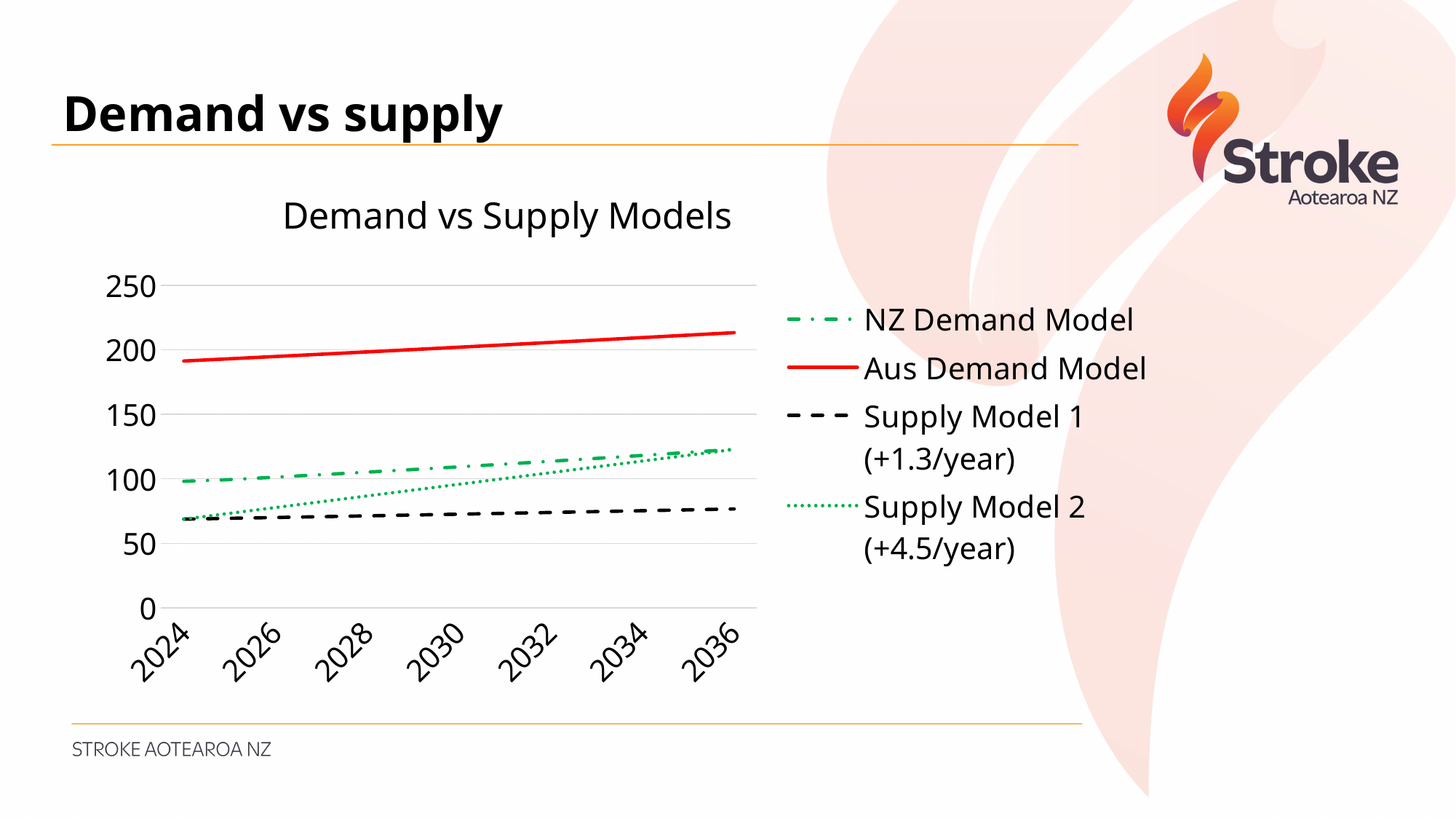
Is the value for the NZ Demand Model in 2036 greater or less than 100? greater How many year labels are shown on the x axis? 7 Which series has the lowest value in 2036? Supply Model 1 (+1.3/year) Which series has the highest values across the whole period? Aus Demand Model Is the value for the Aus Demand Model in 2024 greater or less than 150? greater In 2036, which is larger: Supply Model 1 or Supply Model 2? Supply Model 2 How many series does the chart legend list? 4 What is the title of the chart? Demand vs Supply Models Which series is drawn as a solid red line? Aus Demand Model Does the Supply Model 2 line rise or fall from 2024 to 2036? rise What kind of chart is shown on the slide? line chart Is the value for Supply Model 1 in 2036 greater or less than 100? less